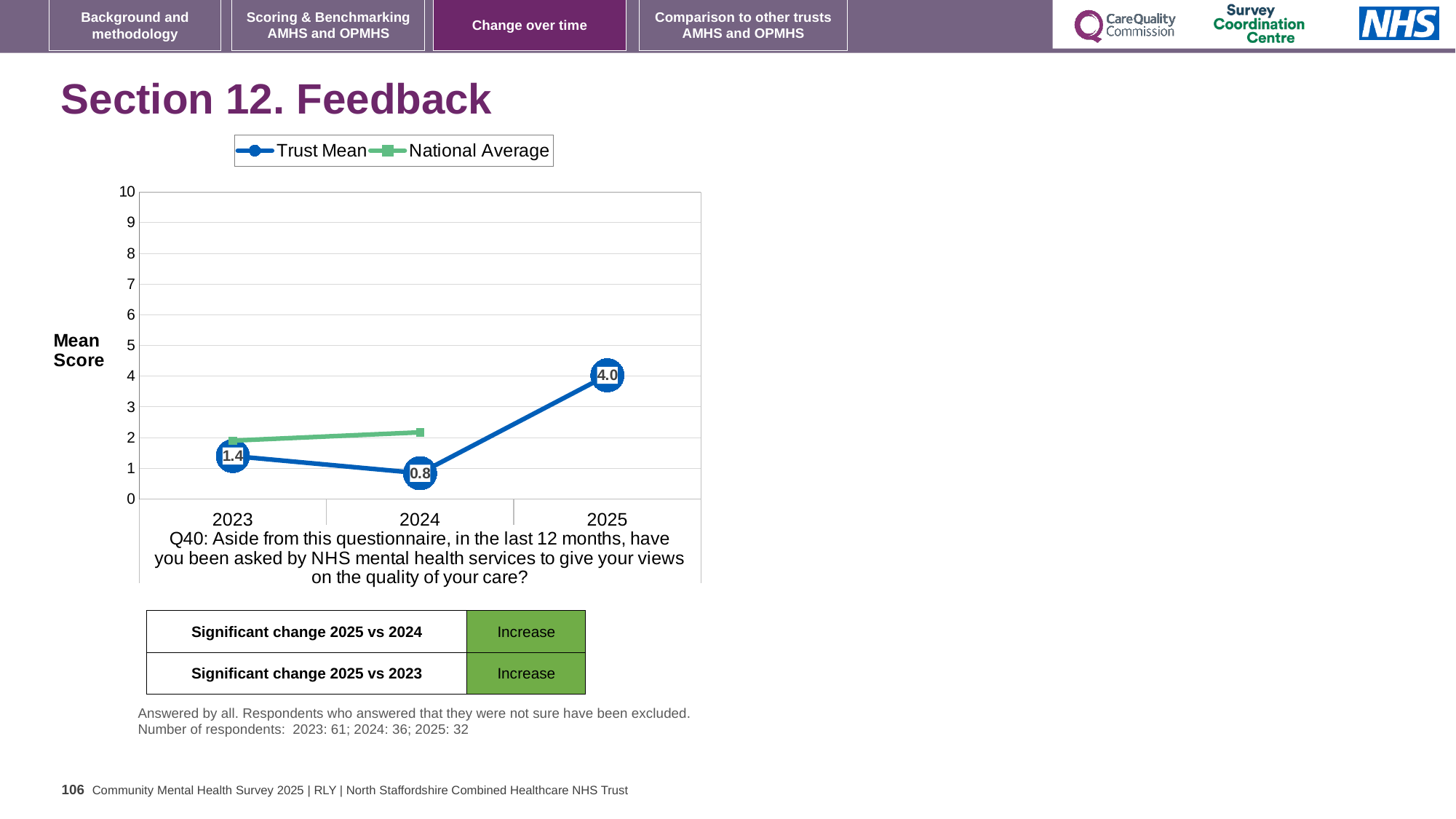
What is the Trust Mean score for 2024? 0.8 By how much did the Trust Mean increase from 2024 to 2025? 3.2 Is the National Average value for 2024 greater or less than 3? less How many series does the chart legend list? 2 In 2023, which series has the higher value: Trust Mean or National Average? National Average What is the difference between the Trust Mean in 2023 and in 2024? 0.6 In which year is the Trust Mean lowest? 2024 What type of chart is shown on the slide? line chart In which year is the Trust Mean highest? 2025 What is the Trust Mean score for 2023? 1.4 How many years are shown on the x axis of the chart? 3 What is the Trust Mean score for 2025? 4.0